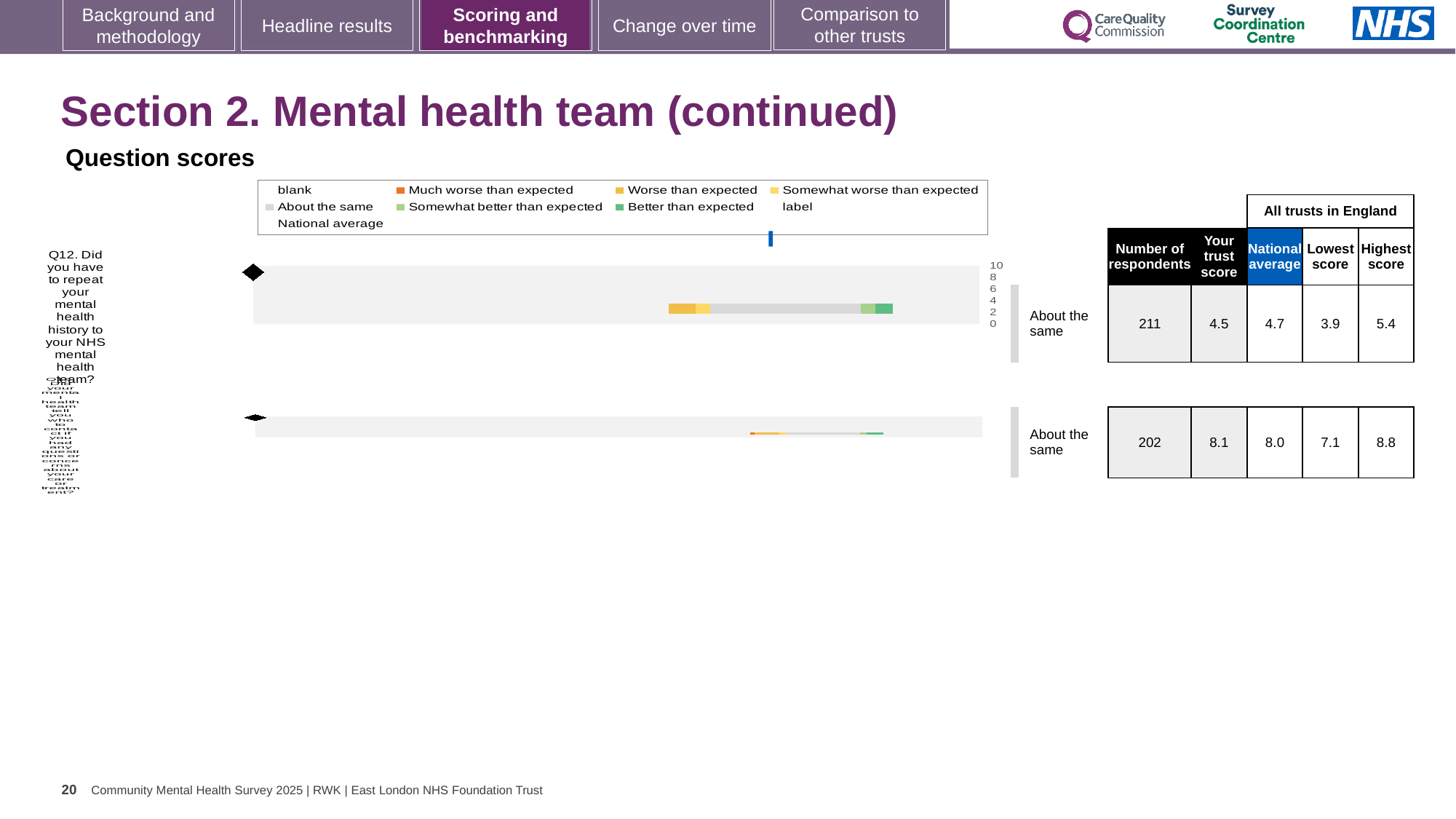
What is the lowest score among all trusts in England for the second question row? 7.1 What is the trust's score for the second question row in the table? 8.1 What is the national average for Q12? 4.7 How many question bars are plotted in the chart? 2 For Q12, which is larger: the trust's score or the national average? national average What is the highest score among all trusts in England for Q12? 5.4 What kind of chart is shown on the slide? bar chart What benchmark category is shown for Q12 next to the chart? About the same What is the trust's score for Q12? 4.5 What is the difference between the highest and lowest scores for Q12? 1.5 How many more respondents answered Q12 than the second question? 9 What is the number of respondents for Q12 in the table beside the chart? 211